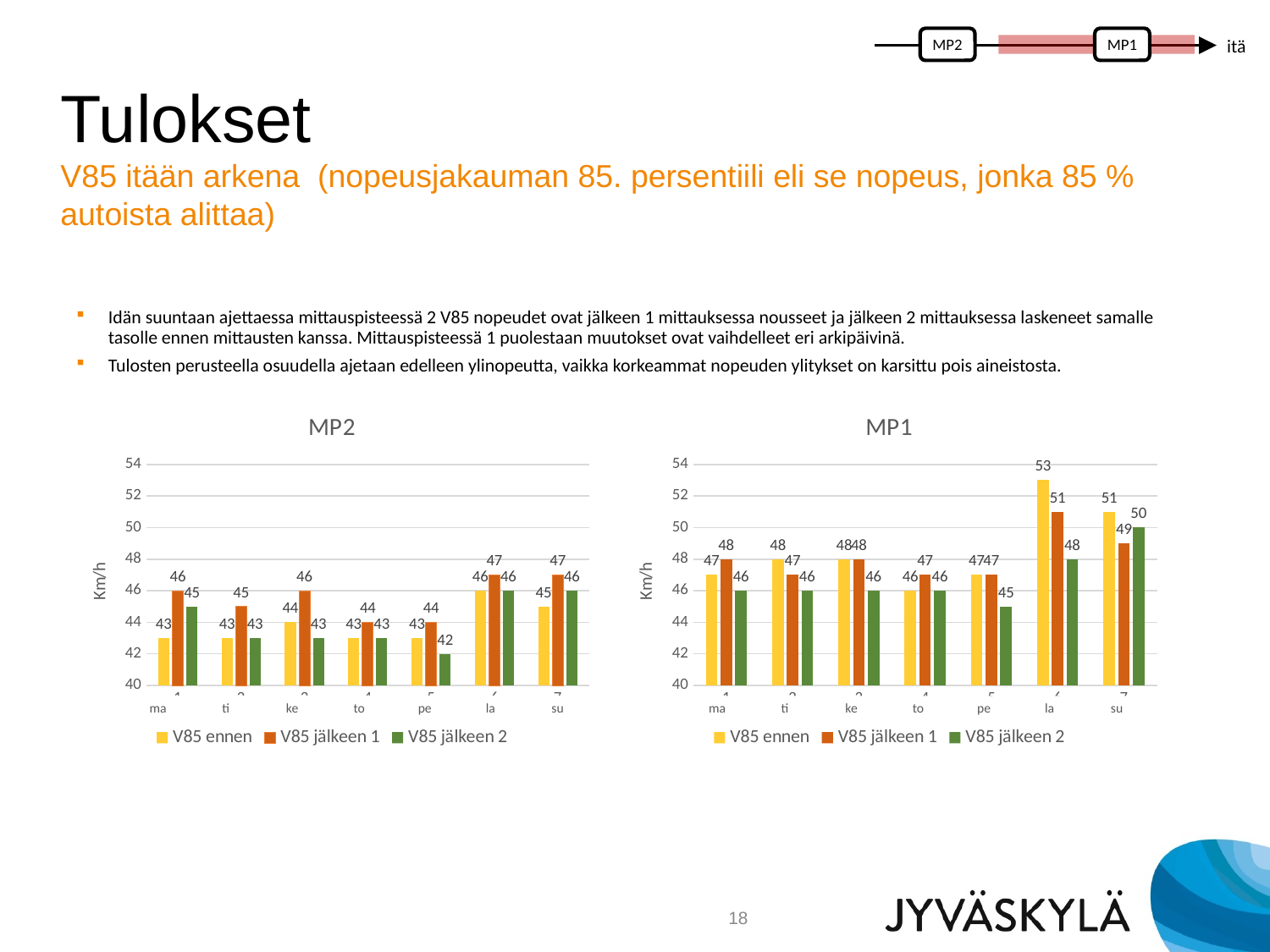
What is the y-axis label of the MP2 chart? Km/h In the MP2 chart, what is the value of V85 jälkeen 2 for pe? 42 How many days are shown on the x axis of the MP2 chart? 7 In the MP1 chart, what is the value of V85 jälkeen 2 for su? 50 In the MP2 chart, which day has the lowest V85 jälkeen 2 value? pe How many series does the legend of the MP1 chart list? 3 In the MP1 chart, what is the value of V85 ennen for la? 53 In the MP1 chart, what is the difference between V85 ennen and V85 jälkeen 2 for la? 5 In the MP2 chart, what is the value of V85 jälkeen 1 for ma? 46 What type of chart is the MP1 chart? bar chart In the MP1 chart, which day has the highest V85 ennen value? la In the MP2 chart, which is larger for ke: V85 jälkeen 1 or V85 jälkeen 2? V85 jälkeen 1